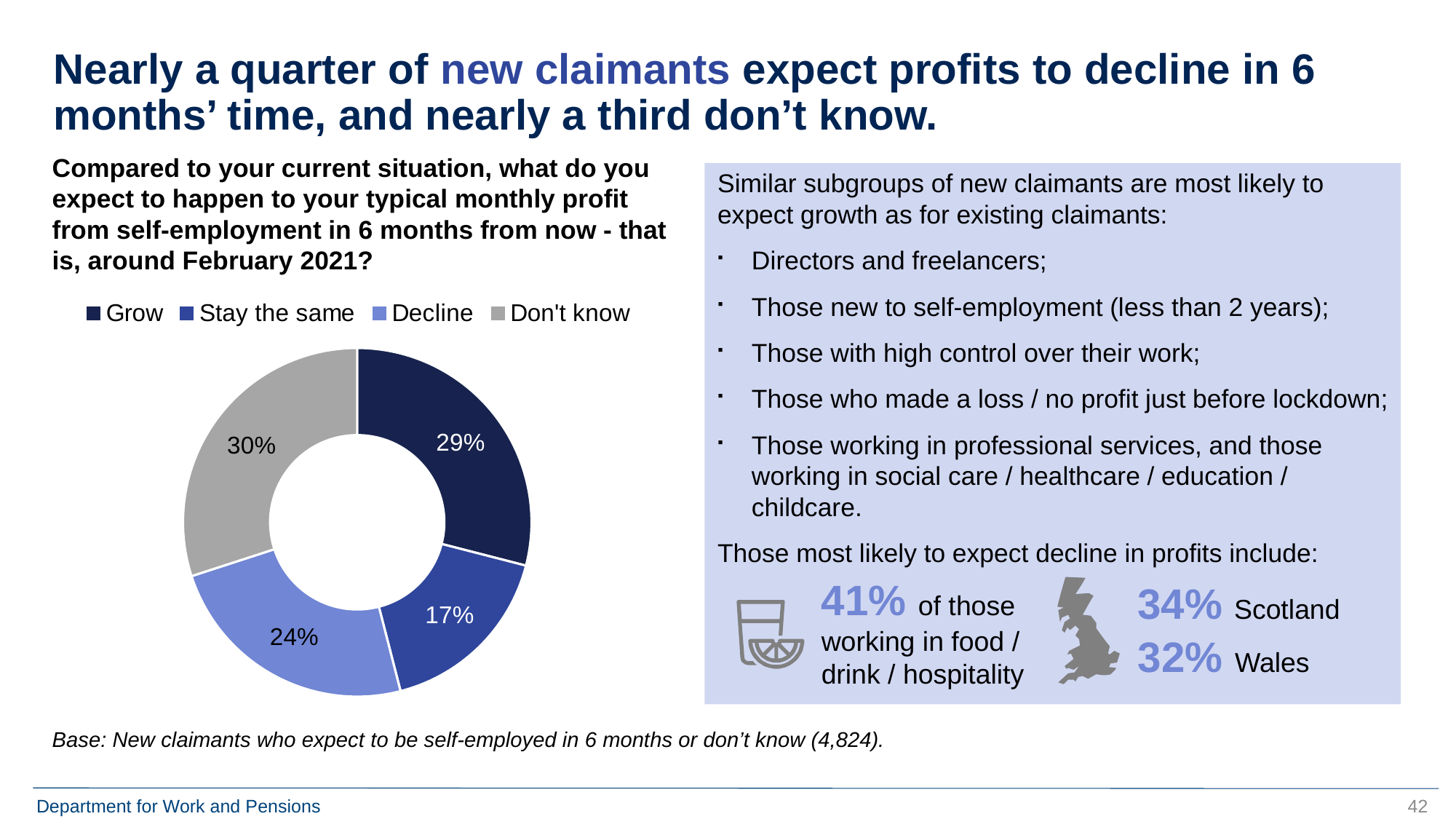
What colour is used for the 'Don't know' segment of the chart? Grey What percentage of new claimants expect their profit to stay the same? 17% Which is larger, the share for 'Grow' or the share for 'Decline'? Grow Which response category has the largest share of the chart? Don't know How many entries does the chart legend list? 4 What percentage of new claimants expect their profit to grow? 29% What is the difference in percentage points between 'Don't know' and 'Stay the same'? 13 How many response categories are shown in the chart? 4 What type of chart is used to show the expected change in monthly profit? Doughnut chart Which response category has the smallest share of the chart? Stay the same What percentage of new claimants expect their profit to decline? 24% What percentage of new claimants answered 'Don't know'? 30%